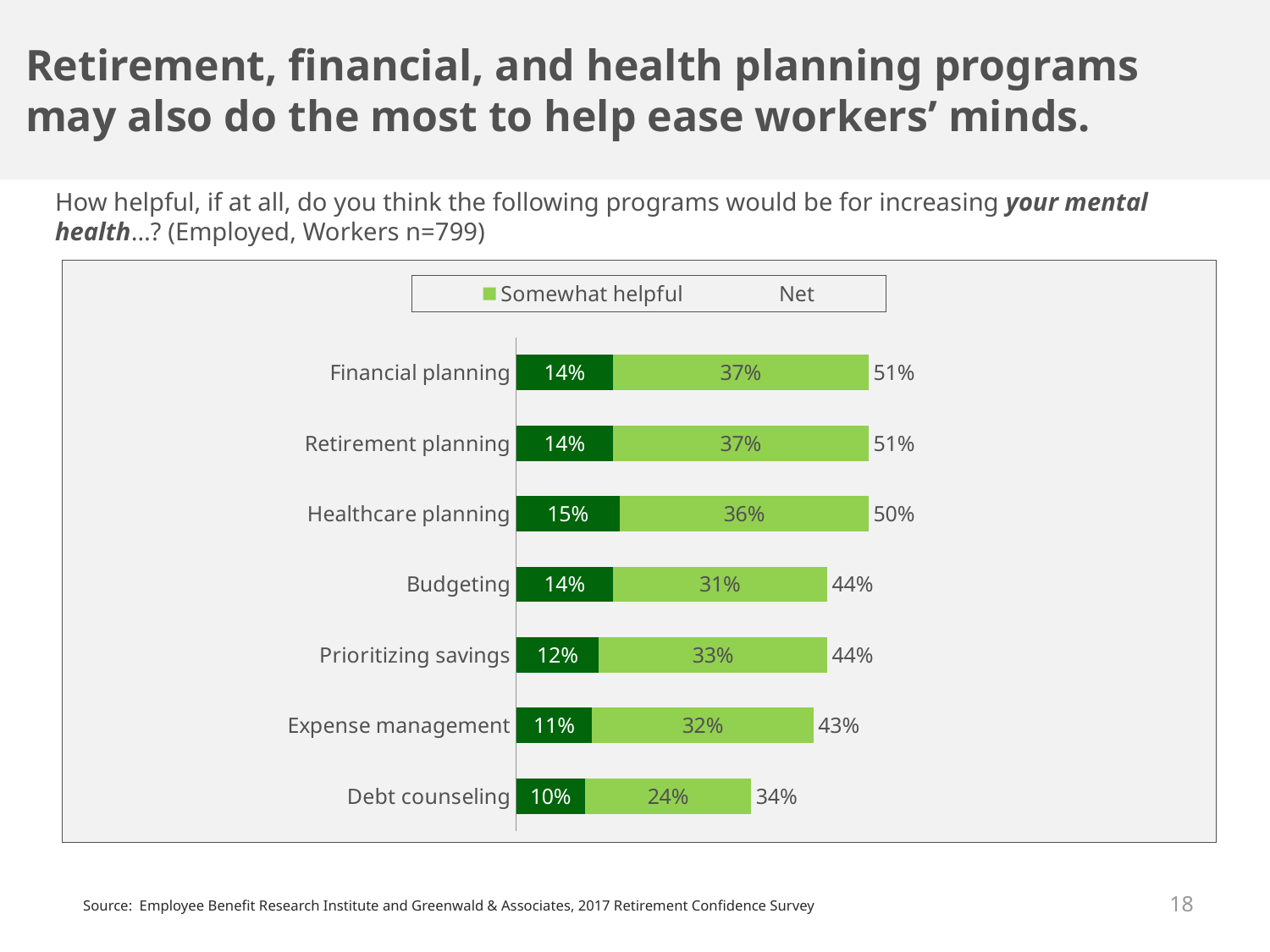
Which has the larger "Somewhat helpful" value, Budgeting or Prioritizing savings? Prioritizing savings Which program has the lowest "Somewhat helpful" value? Debt counseling Which program has the lowest Net value? Debt counseling What is the Net value for Healthcare planning? 50% What is the value of the dark green segment for Healthcare planning? 15% What kind of chart is shown on the slide? Stacked bar chart How many programs are listed in the chart? 7 What colour represents "Somewhat helpful" in the legend? Light green What is the difference between the Net value for Financial planning and the Net value for Debt counseling? 17 percentage points What is the "Somewhat helpful" value for Expense management? 32% What is the Net value for Debt counseling? 34% What is the "Somewhat helpful" value for Financial planning? 37%